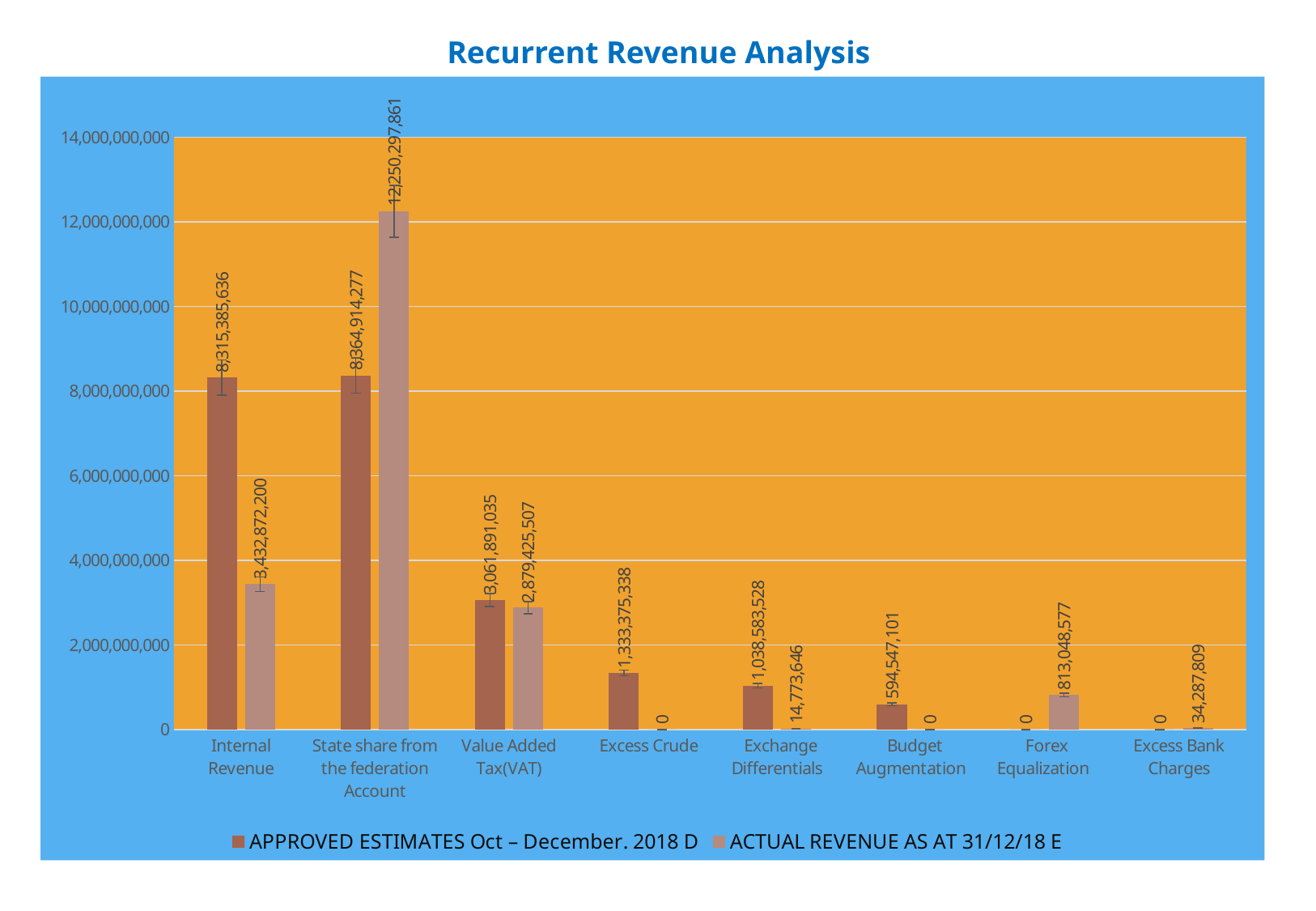
What is the actual revenue as at 31/12/18 for Exchange Differentials? 14,773,646 What is the actual revenue as at 31/12/18 for State share from the federation Account? 12,250,297,861 Which category has the highest actual revenue as at 31/12/18? State share from the federation Account What type of chart is shown on the slide? Bar chart Which category has the highest approved estimate? State share from the federation Account What is the approved estimate (Oct – December 2018) for Value Added Tax(VAT)? 3,061,891,035 How many revenue categories are shown on the x axis? 8 For Forex Equalization, which is larger: the approved estimate or the actual revenue? Actual revenue What is the difference between the approved estimate and the actual revenue for Value Added Tax(VAT)? 182,465,528 How many series does the legend list? 2 What is the approved estimate for Budget Augmentation? 594,547,101 What is the difference between the approved estimate and the actual revenue for Internal Revenue? 4,882,513,436